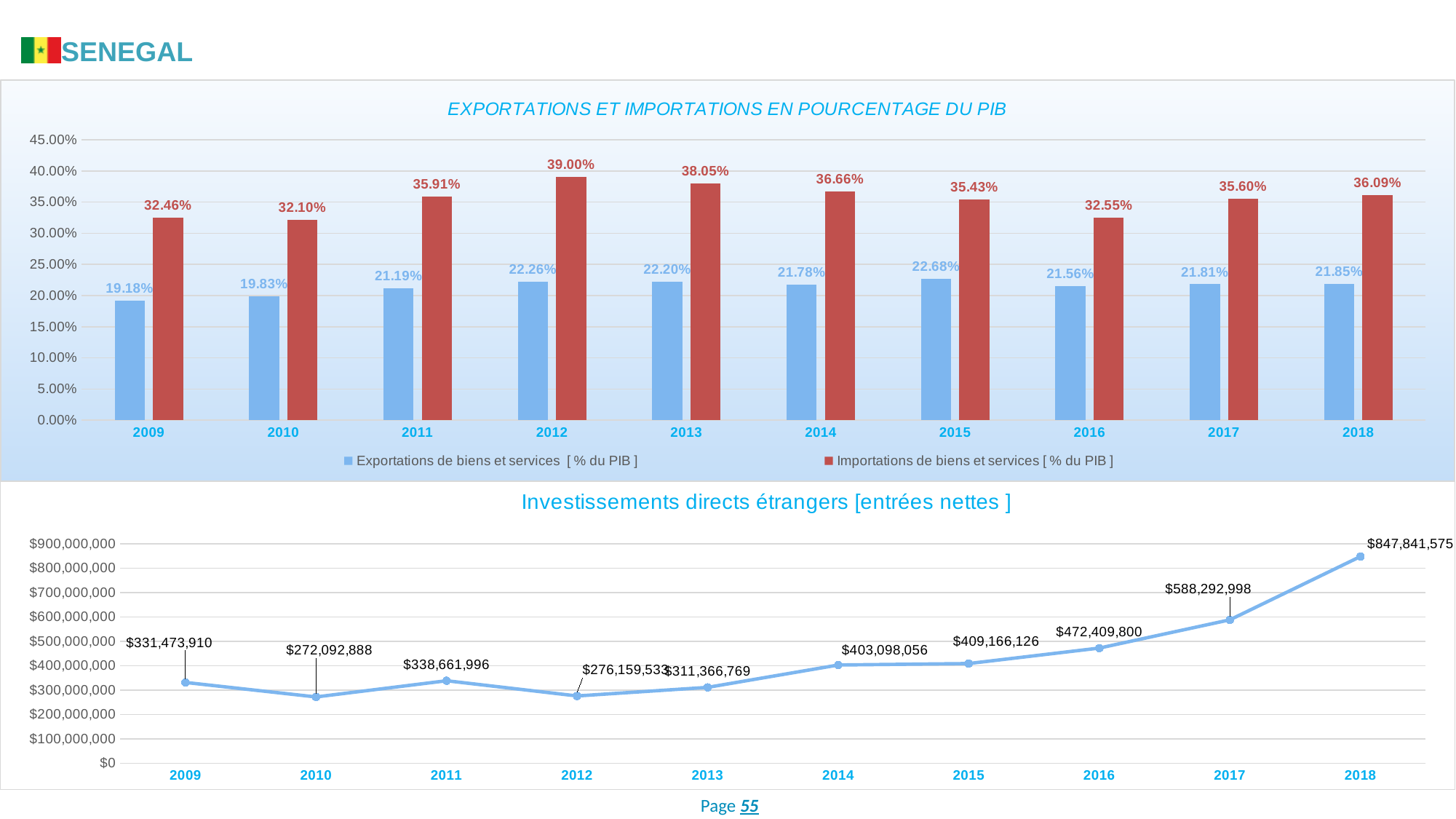
In the chart 'Investissements directs étrangers [entrées nettes ]', which year has the lowest value? 2010 In the chart 'EXPORTATIONS ET IMPORTATIONS EN POURCENTAGE DU PIB', which year has the larger value for Exportations de biens et services, 2015 or 2016? 2015 What kind of chart is 'EXPORTATIONS ET IMPORTATIONS EN POURCENTAGE DU PIB'? bar chart How many series does the legend of the chart 'EXPORTATIONS ET IMPORTATIONS EN POURCENTAGE DU PIB' list? 2 In the chart 'EXPORTATIONS ET IMPORTATIONS EN POURCENTAGE DU PIB', what is the value of Importations de biens et services for 2012? 39.00% In the chart 'EXPORTATIONS ET IMPORTATIONS EN POURCENTAGE DU PIB', which year has the lowest value for Exportations de biens et services? 2009 In the chart 'Investissements directs étrangers [entrées nettes ]', do the values rise or fall from 2013 to 2018? rise In the chart 'Investissements directs étrangers [entrées nettes ]', what is the difference between the 2018 and 2017 values? $259,548,577 In the chart 'EXPORTATIONS ET IMPORTATIONS EN POURCENTAGE DU PIB', which year has the highest value for Importations de biens et services? 2012 In the chart 'Investissements directs étrangers [entrées nettes ]', what is the value for 2018? $847,841,575 In the chart 'EXPORTATIONS ET IMPORTATIONS EN POURCENTAGE DU PIB', what is the value of Exportations de biens et services for 2009? 19.18% In the chart 'EXPORTATIONS ET IMPORTATIONS EN POURCENTAGE DU PIB', what is the difference between Importations and Exportations in 2012? 16.74%